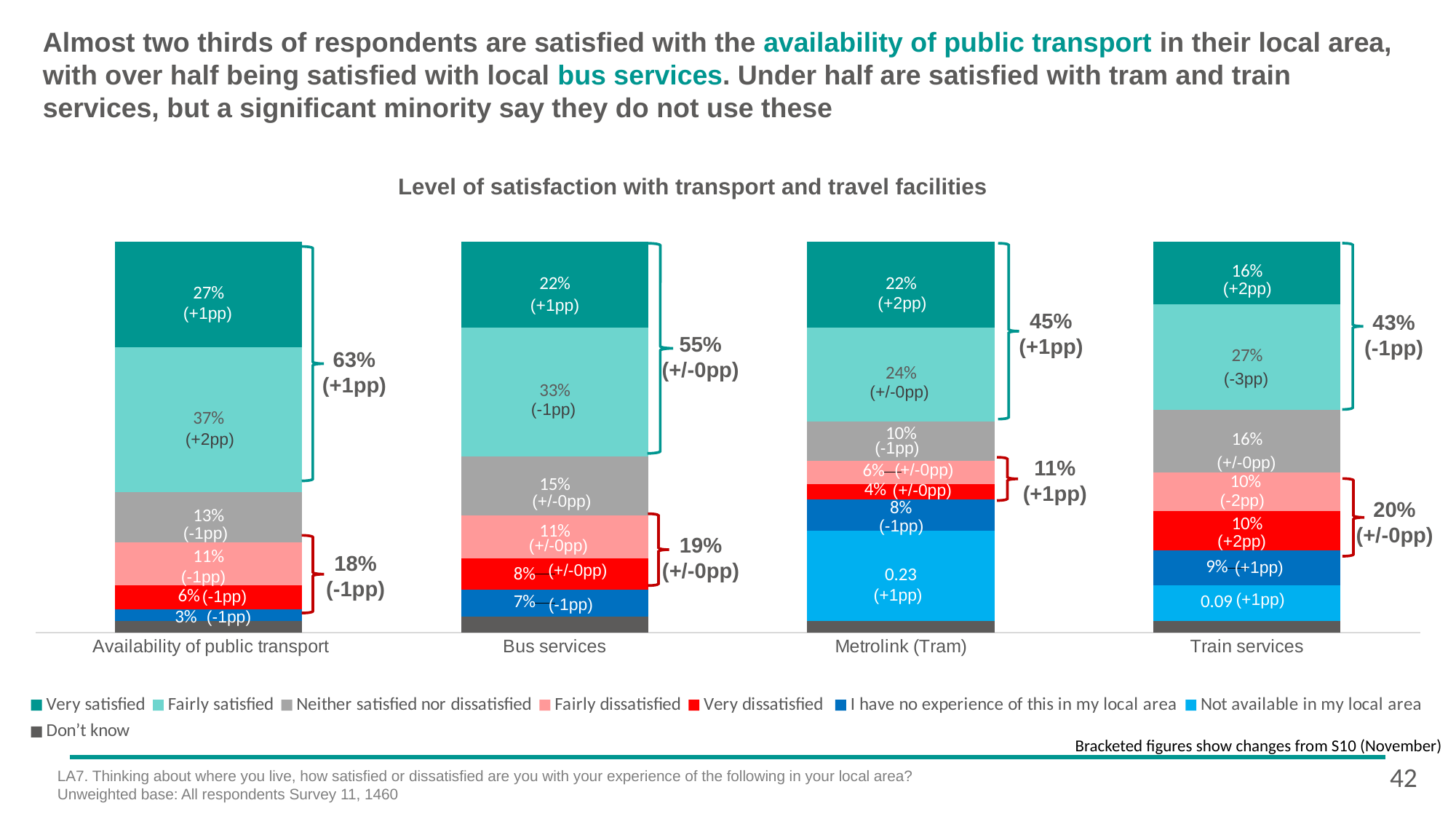
What value is shown for 'Not available in my local area' for Metrolink (Tram)? 0.23 What is the difference between the very satisfied percentage for Availability of public transport and for Train services? 11% What is the combined very satisfied and fairly satisfied total for Train services? 43% What is the fairly satisfied value for Bus services? 33% Which category has the highest very satisfied percentage? Availability of public transport Which category has the lowest fairly satisfied percentage? Metrolink (Tram) What kind of chart is shown on the slide? Stacked bar chart How many categories are shown on the x axis of the chart? 4 How many series does the legend list? 8 What is the title of the chart? Level of satisfaction with transport and travel facilities Which has a larger 'Neither satisfied nor dissatisfied' share, Bus services or Train services? Train services What percentage of respondents are very satisfied with the availability of public transport? 27%